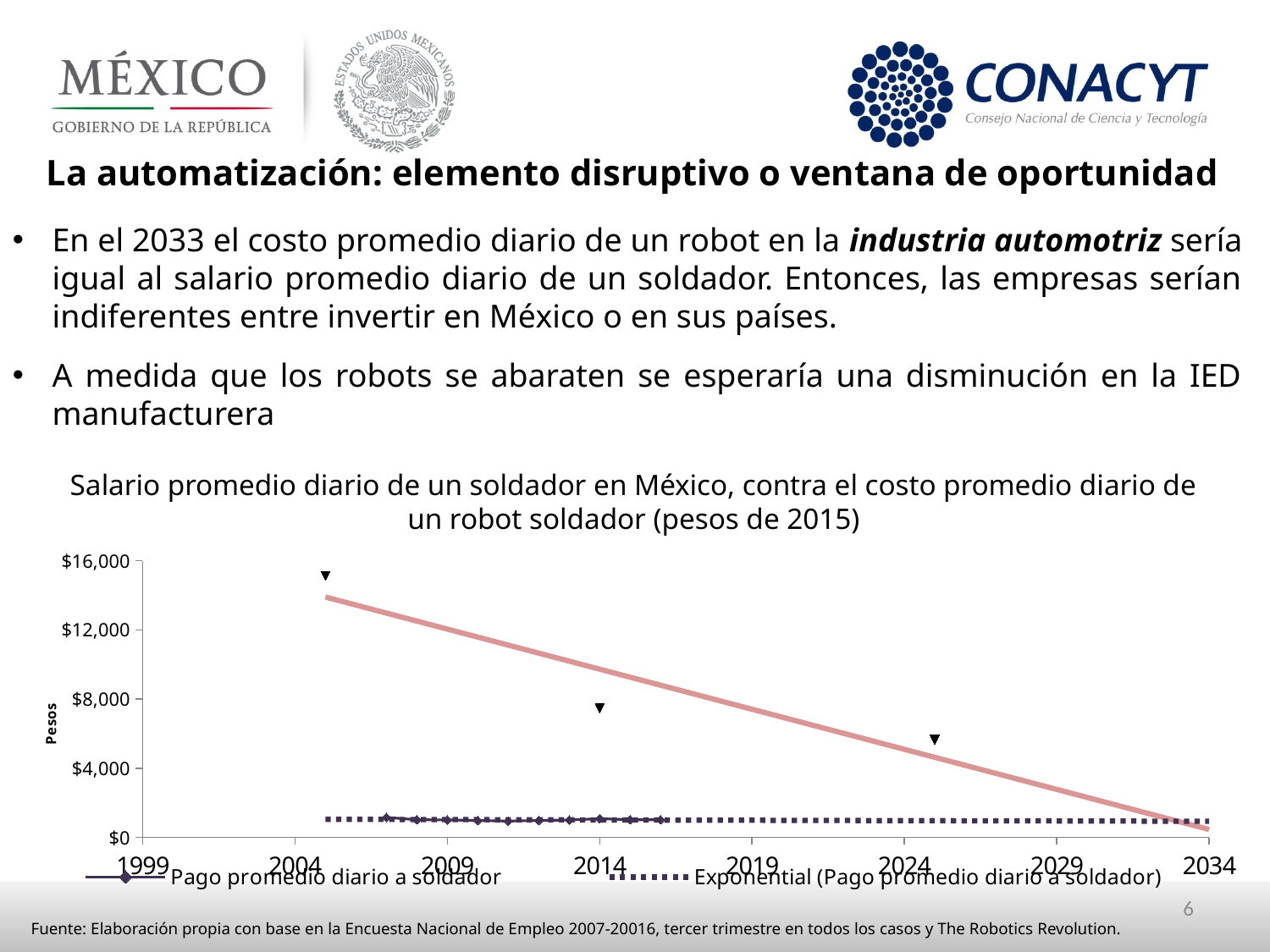
Is the robot cost marker plotted around 2025 greater or less than $4,000? greater Is the robot cost marker plotted around 2005 greater or less than $12,000? greater Is the robot cost marker plotted around 2014 greater or less than $8,000? less What kind of chart is shown on the slide? line chart What is the title of the chart? Salario promedio diario de un soldador en México, contra el costo promedio diario de un robot soldador (pesos de 2015) Around 2014, which is larger: the robot cost marker or the 'Pago promedio diario a soldador' value? the robot cost marker What is the highest value shown on the vertical axis of the chart? $16,000 How many entries does the chart's legend list? 2 Does the pink trend line for the robot cost rise or fall from 2005 to 2034? fall How many triangle markers for the robot cost are plotted on the chart? 3 What is the label on the vertical axis of the chart? Pesos